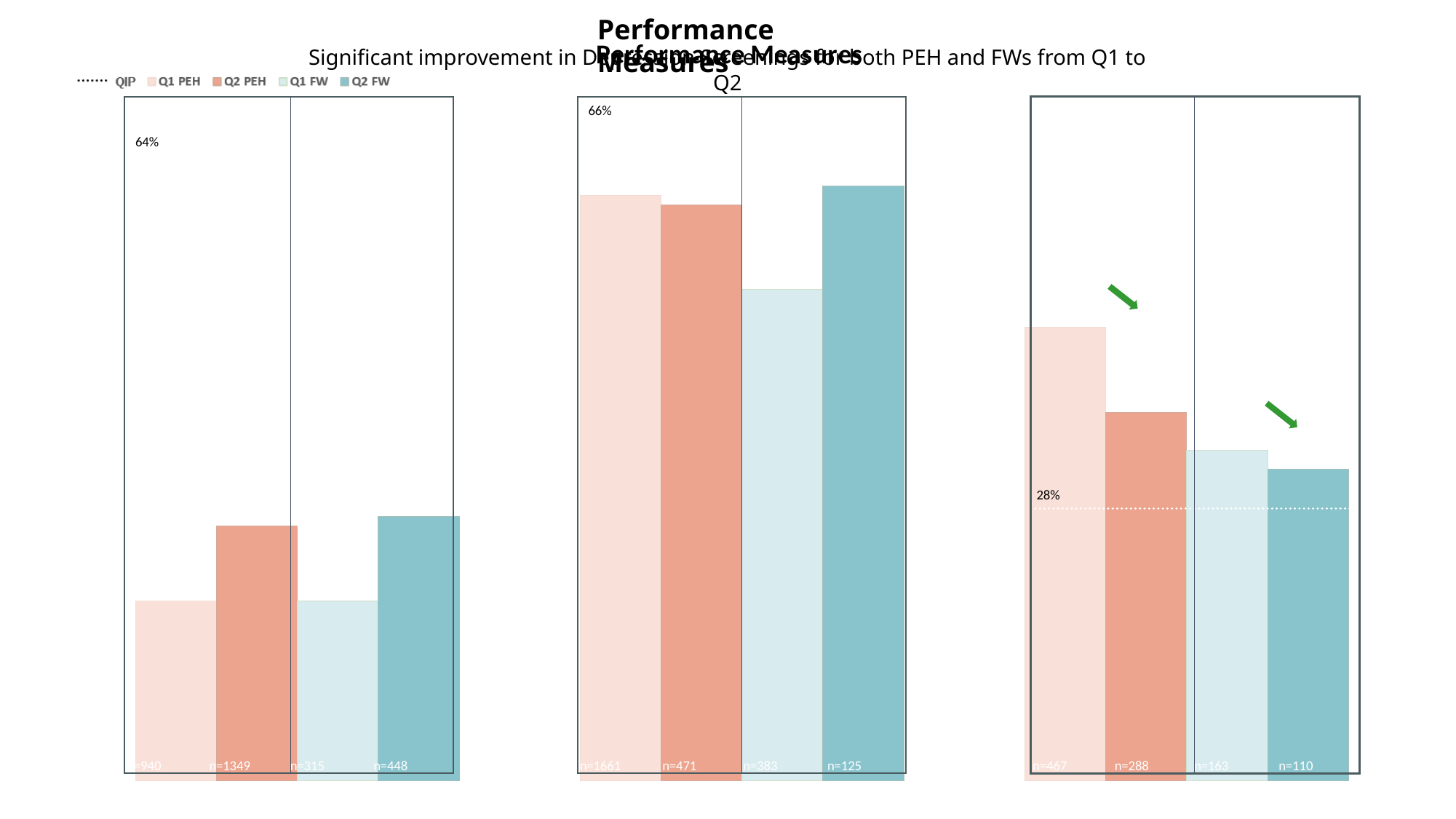
What kind of chart is the left chart on the slide? bar chart What QIP value is labelled on the dotted line in the right chart? 28% In the middle chart, which bar is the shortest? Q1 FW In the middle chart, which bar is the tallest? Q2 FW In the left chart, is the Q2 PEH bar taller or shorter than the Q1 PEH bar? taller In the right chart, which bar is the tallest? Q1 PEH How many bars are plotted in the right chart? 4 In the right chart, is the Q2 PEH bar taller or shorter than the Q1 PEH bar? shorter In the left chart, which bar is the tallest? Q2 FW In the right chart, which bar is the shortest? Q2 FW How many entries does the legend list? 5 What sample size (n) is printed under the Q2 PEH bar in the left chart? n=1349